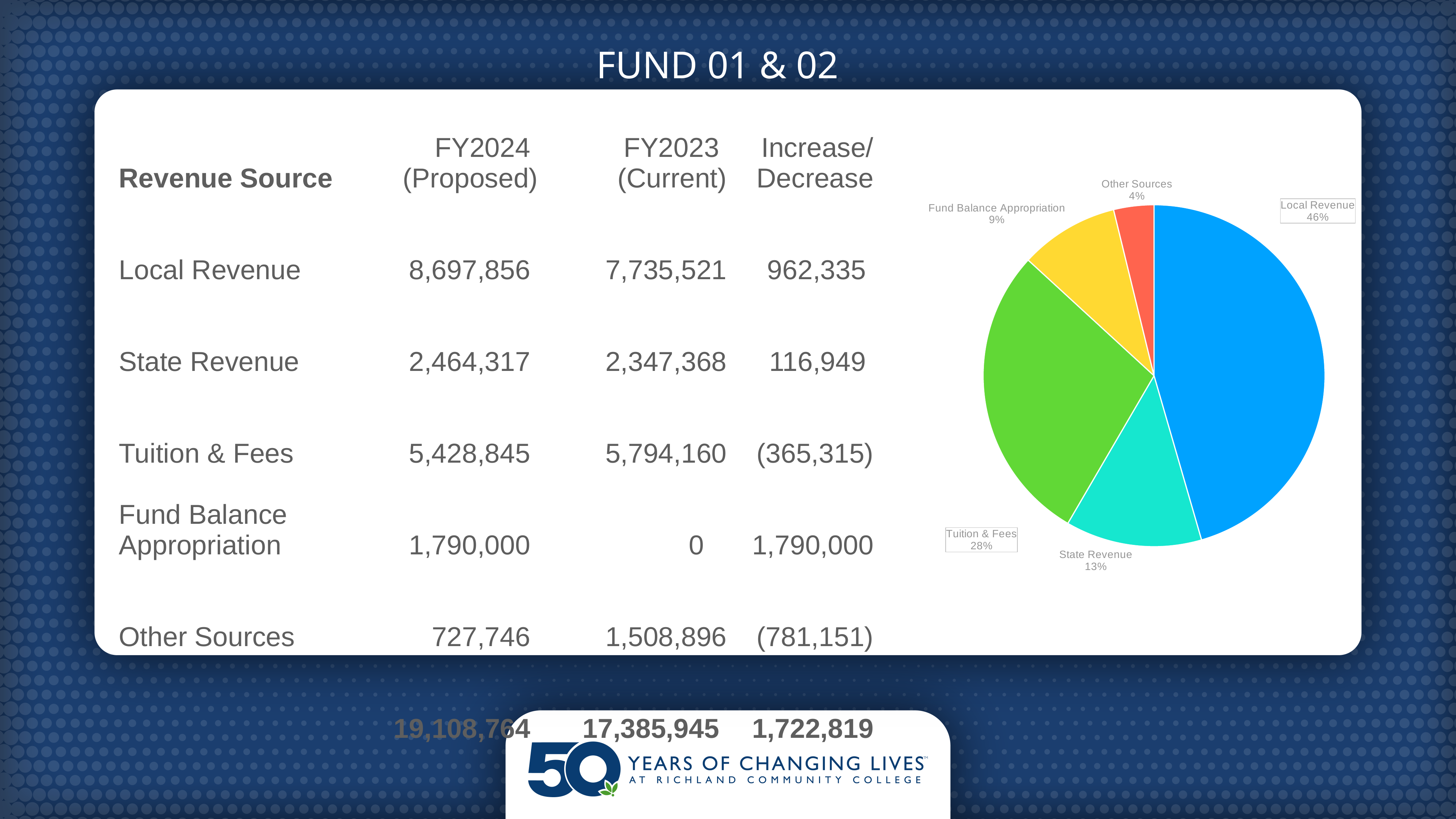
What share of the pie chart does Local Revenue represent? 46% What kind of chart is shown on the slide? pie chart How many slices does the pie chart have? 5 What share of the pie chart does State Revenue represent? 13% What share of the pie chart does Tuition & Fees represent? 28% What colour is the Local Revenue slice in the pie chart? blue In the pie chart, what is the difference in percentage points between Local Revenue and Tuition & Fees? 18 Which slice of the pie chart is the largest? Local Revenue Which slice of the pie chart is the smallest? Other Sources In the pie chart, which is larger: Tuition & Fees or State Revenue? Tuition & Fees